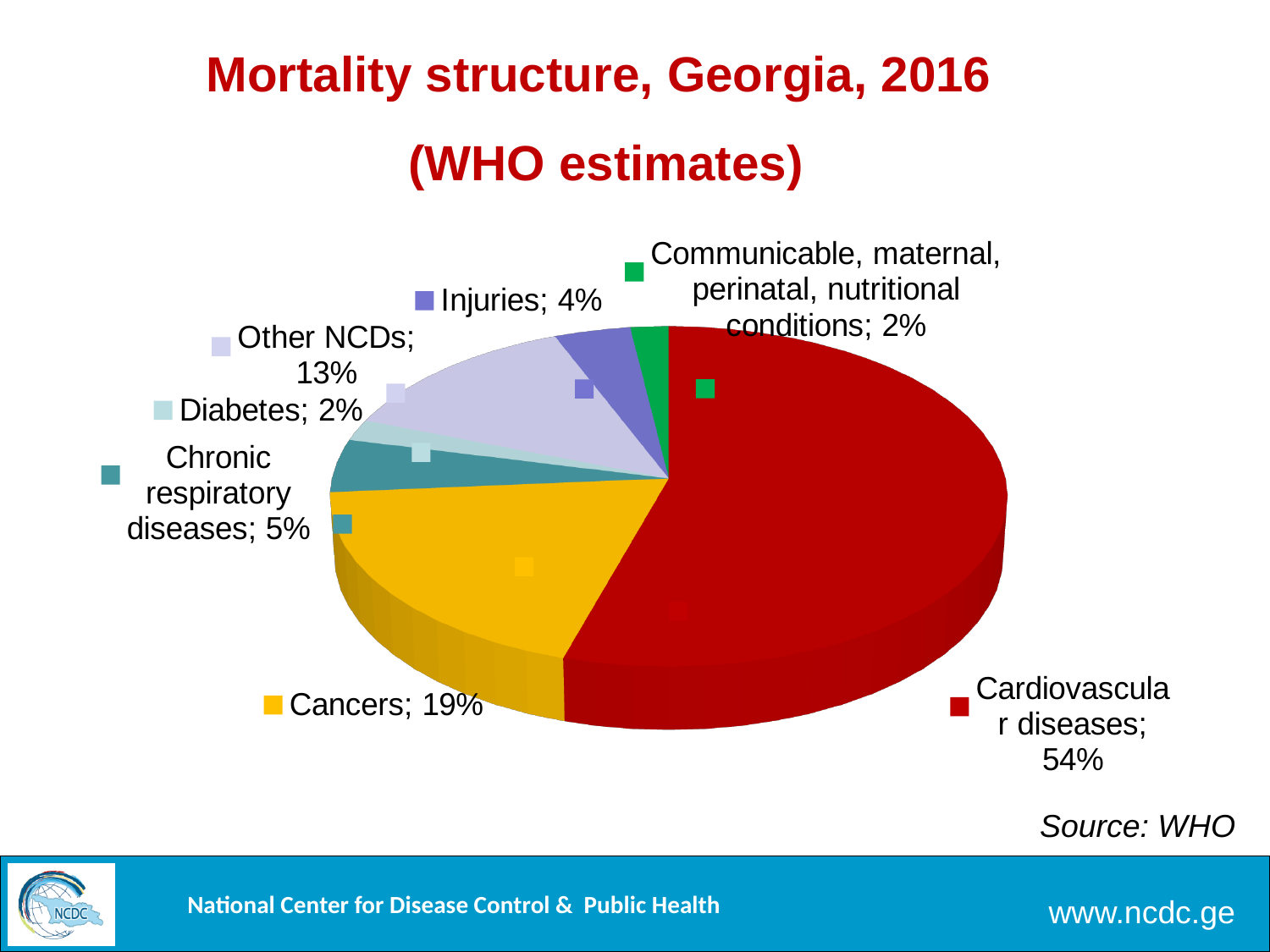
Which is larger, the share for Cancers or the share for Other NCDs? Cancers What percentage of the pie is Cancers? 19% What is the value shown for Other NCDs? 13% What is the share for Injuries? 4% What is the difference in percentage points between Cardiovascular diseases and Cancers? 35 What kind of chart is shown on the slide? pie chart Which category has the largest share of the pie? Cardiovascular diseases How many categories are shown in the pie chart? 7 What is the title of the chart on the slide? Mortality structure, Georgia, 2016 (WHO estimates) What share of mortality is attributed to Cardiovascular diseases? 54% What percentage is shown for Communicable, maternal, perinatal, nutritional conditions? 2% What percentage is shown for Chronic respiratory diseases? 5%